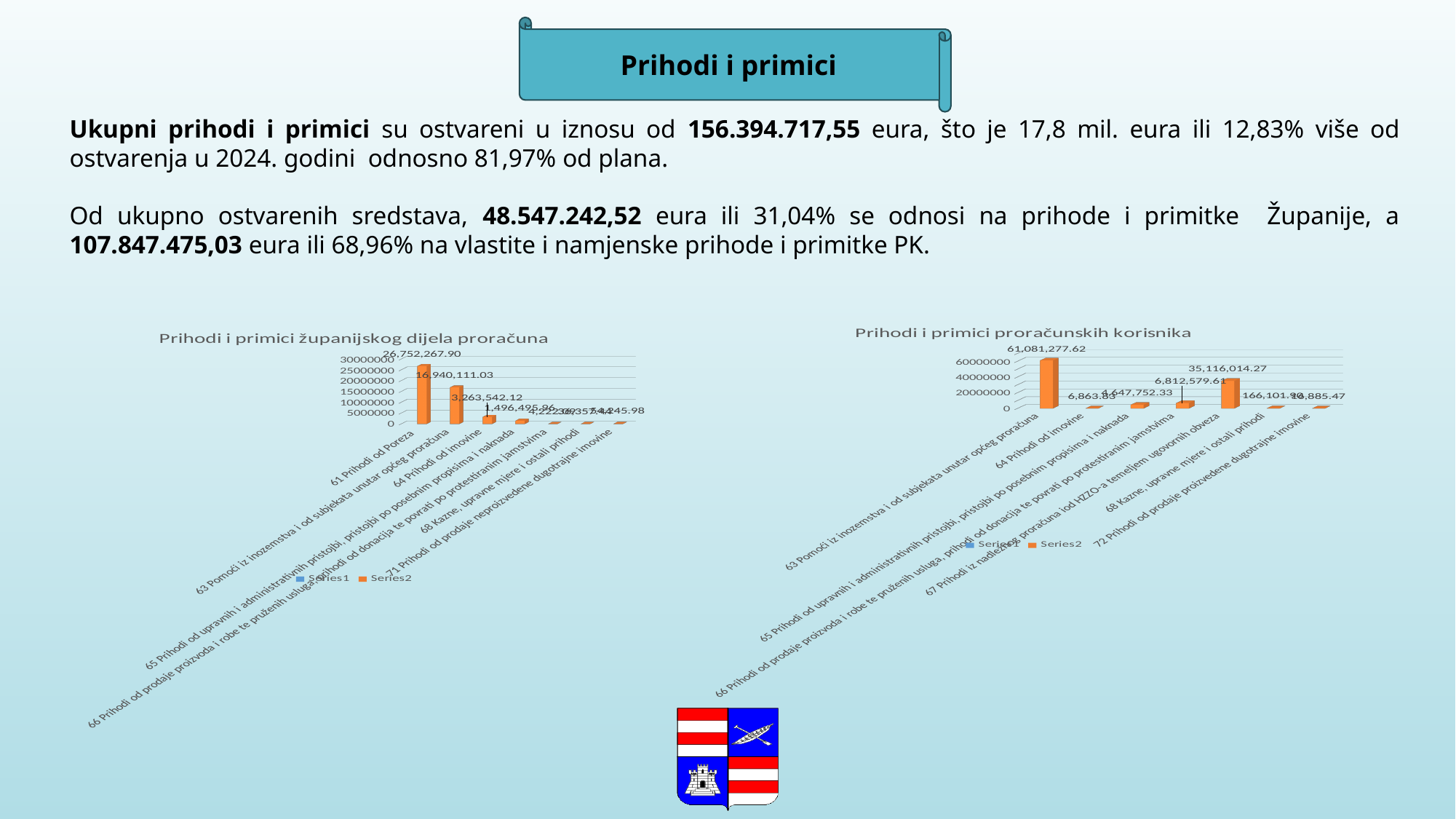
In the chart 'Prihodi i primici županijskog dijela proračuna', which category has the highest value? 61 Prihodi od Poreza In the chart 'Prihodi i primici županijskog dijela proračuna', how many series does the legend list? 2 In the chart 'Prihodi i primici proračunskih korisnika', what is the difference between '63 Pomoći iz inozemstva i od subjekata unutar općeg proračuna' and '67 Prihodi iz nadležnog proračuna i od HZZO-a temeljem ugovornih obveza'? 25,965,263.35 In the chart 'Prihodi i primici županijskog dijela proračuna', what is the difference between '61 Prihodi od Poreza' and '63 Pomoći iz inozemstva i od subjekata unutar općeg proračuna'? 9,812,156.87 How many categories are shown in the chart 'Prihodi i primici proračunskih korisnika'? 7 In the chart 'Prihodi i primici županijskog dijela proračuna', what is the value for '61 Prihodi od Poreza'? 26,752,267.90 In the chart 'Prihodi i primici proračunskih korisnika', what is the value for '63 Pomoći iz inozemstva i od subjekata unutar općeg proračuna'? 61,081,277.62 In the chart 'Prihodi i primici proračunskih korisnika', which is larger: '66 Prihodi od prodaje proizvoda i robe te pruženih usluga, prihodi od donacija te povrati po protestiranim jamstvima' or '65 Prihodi od upravnih i administrativnih pristojbi, pristojbi po posebnim propisima i naknada'? 66 Prihodi od prodaje proizvoda i robe te pruženih usluga, prihodi od donacija te povrati po protestiranim jamstvima In the chart 'Prihodi i primici proračunskih korisnika', what is the value for '67 Prihodi iz nadležnog proračuna i od HZZO-a temeljem ugovornih obveza'? 35,116,014.27 In the chart 'Prihodi i primici proračunskih korisnika', is the value for '63 Pomoći iz inozemstva i od subjekata unutar općeg proračuna' greater or less than 40000000? greater In the chart 'Prihodi i primici županijskog dijela proračuna', what is the value for '64 Prihodi od imovine'? 3,263,542.12 What kind of chart is 'Prihodi i primici županijskog dijela proračuna'? bar chart